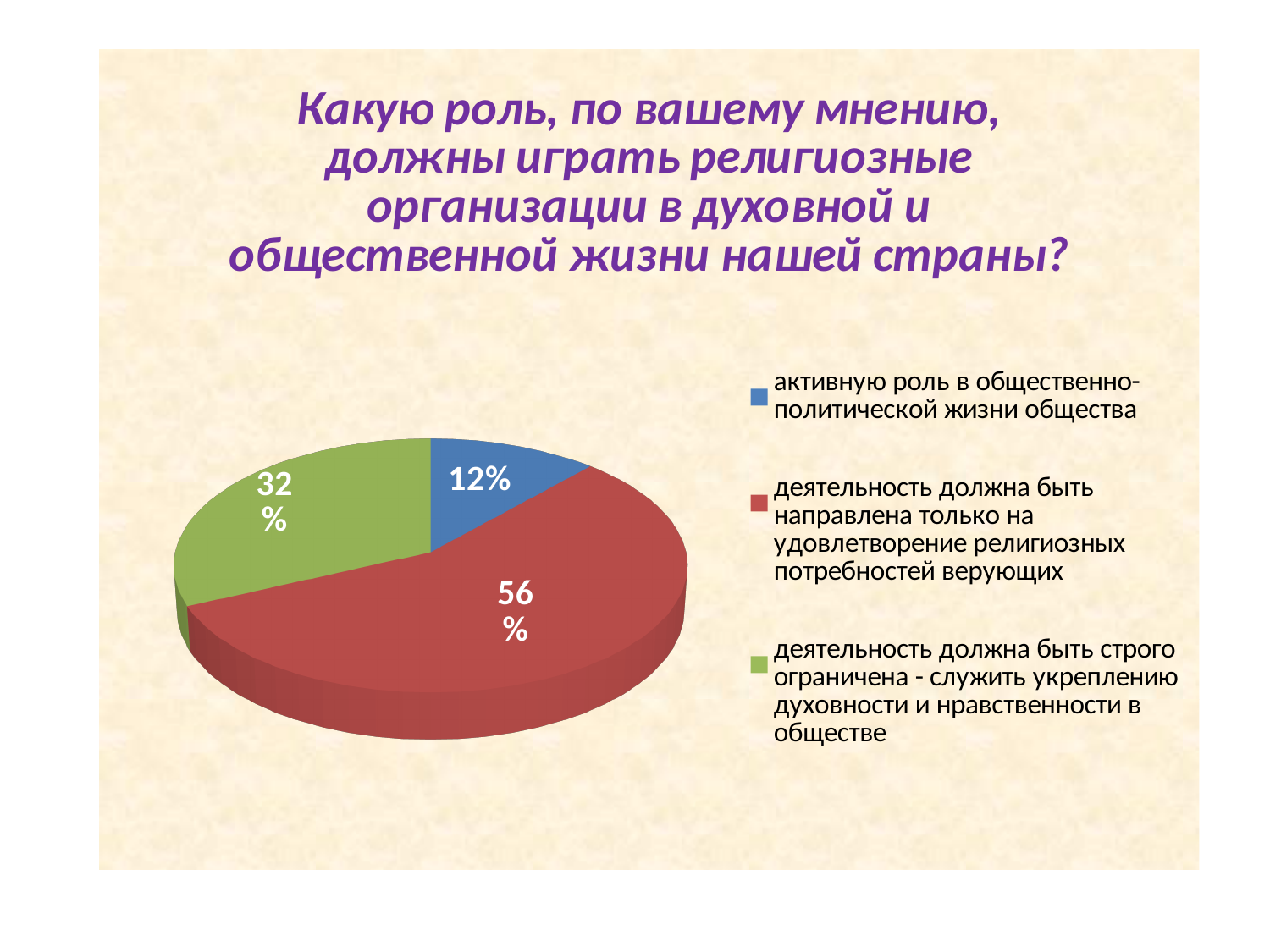
What type of chart is shown on the slide? Pie chart Which response has the smallest share of the pie? активную роль в общественно-политической жизни общества What share of the pie is labelled for 'деятельность должна быть строго ограничена - служить укреплению духовности и нравственности в обществе'? 32% What share of the pie is labelled for 'деятельность должна быть направлена только на удовлетворение религиозных потребностей верующих'? 56% How many slices does the pie chart have? 3 What colour is the slice representing 56%? Red What is the difference in percentage points between the 56% slice and the 32% slice? 24 Which response has the largest share of the pie? деятельность должна быть направлена только на удовлетворение религиозных потребностей верующих What share of the pie is labelled for 'активную роль в общественно-политической жизни общества'? 12% How many entries does the legend list? 3 What colour is the slice representing 12%? Blue Which is larger: the share for 'активную роль в общественно-политической жизни общества' or the share for 'деятельность должна быть строго ограничена - служить укреплению духовности и нравственности в обществе'? деятельность должна быть строго ограничена - служить укреплению духовности и нравственности в обществе